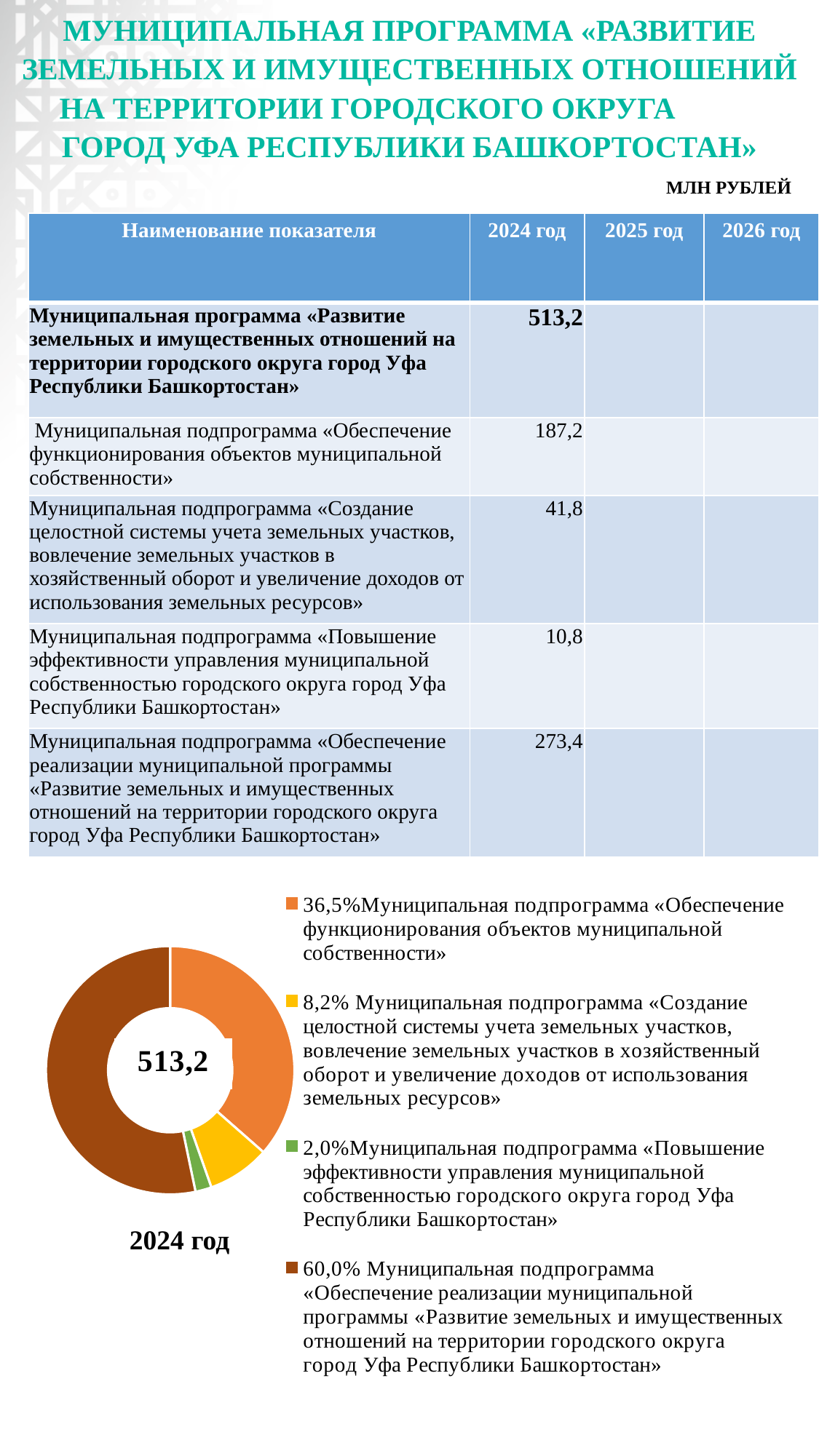
Which subprogram has the smallest slice in the doughnut chart? Муниципальная подпрограмма «Повышение эффективности управления муниципальной собственностью...» (2,0%) What share of the doughnut chart does the subprogram «Обеспечение реализации муниципальной программы...» take? 60,0% What kind of chart is shown at the bottom of the slide? Doughnut (pie) chart What share of the doughnut chart does the subprogram «Создание целостной системы учета земельных участков...» take? 8,2% By how many percentage points does the largest slice (60,0%) exceed the slice for «Обеспечение функционирования объектов муниципальной собственности» (36,5%)? 23,5% Which year is the doughnut chart labelled with? 2024 год What value is printed in the centre of the doughnut chart? 513,2 How many slices does the doughnut chart have? 4 How many entries does the legend of the doughnut chart list? 4 What share of the doughnut chart does the subprogram «Обеспечение функционирования объектов муниципальной собственности» take? 36,5% Which subprogram has the largest slice in the doughnut chart? Муниципальная подпрограмма «Обеспечение реализации муниципальной программы...» (60,0%)